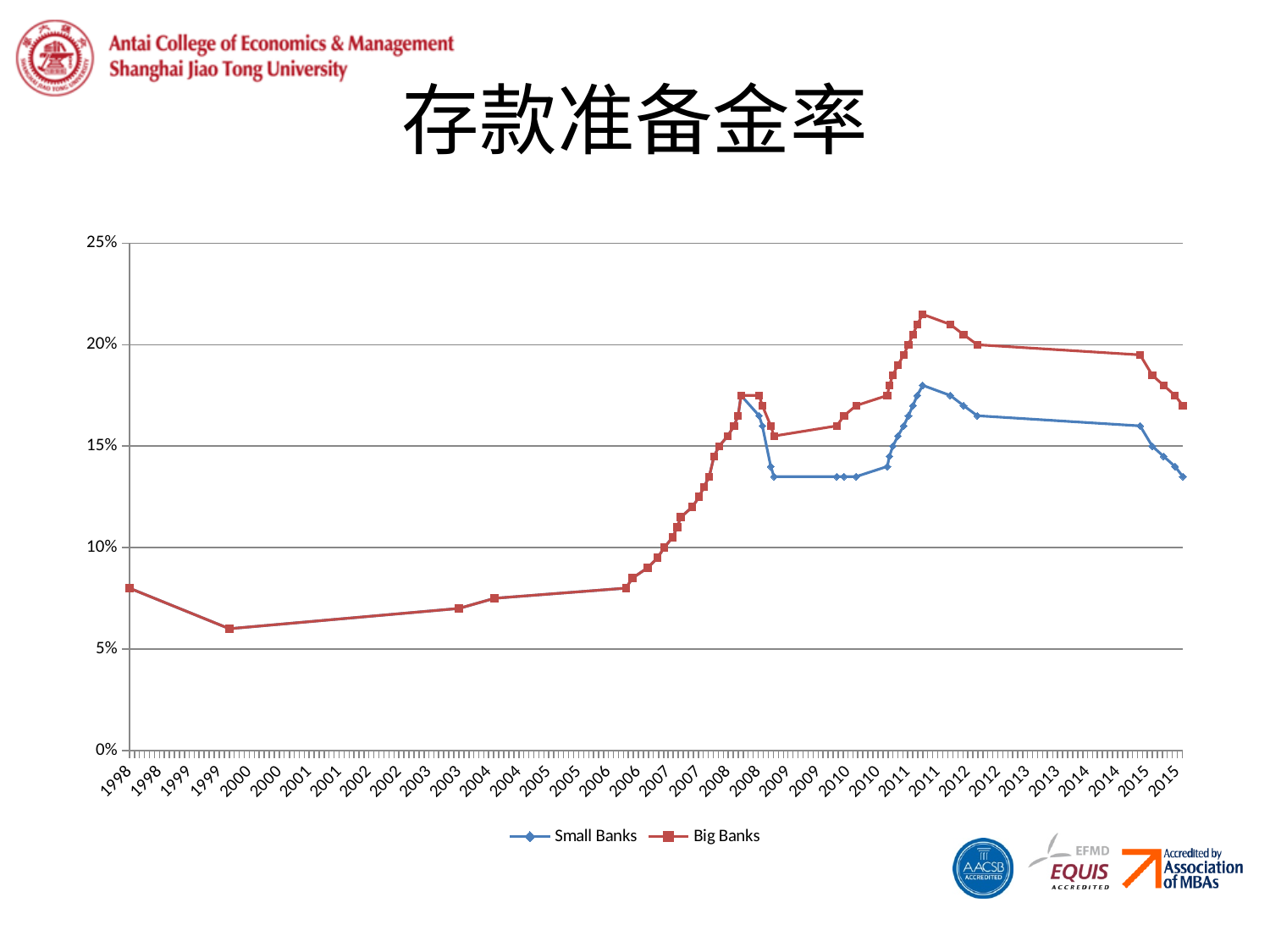
What colour is the Big Banks line? red What kind of chart is shown on the slide? line chart In 2013, which series has the higher value, Small Banks or Big Banks? Big Banks Is the peak value of the Big Banks line in 2011 greater or less than 20%? greater Is the peak value of the Small Banks line in 2011 greater or less than 20%? less Is the value for Big Banks in 1999 greater or less than 5%? greater Which series reaches the higher peak value? Big Banks What are the two series named in the legend? Small Banks and Big Banks Does the Big Banks line rise or fall between 2006 and 2008? rise How many series does the legend list? 2